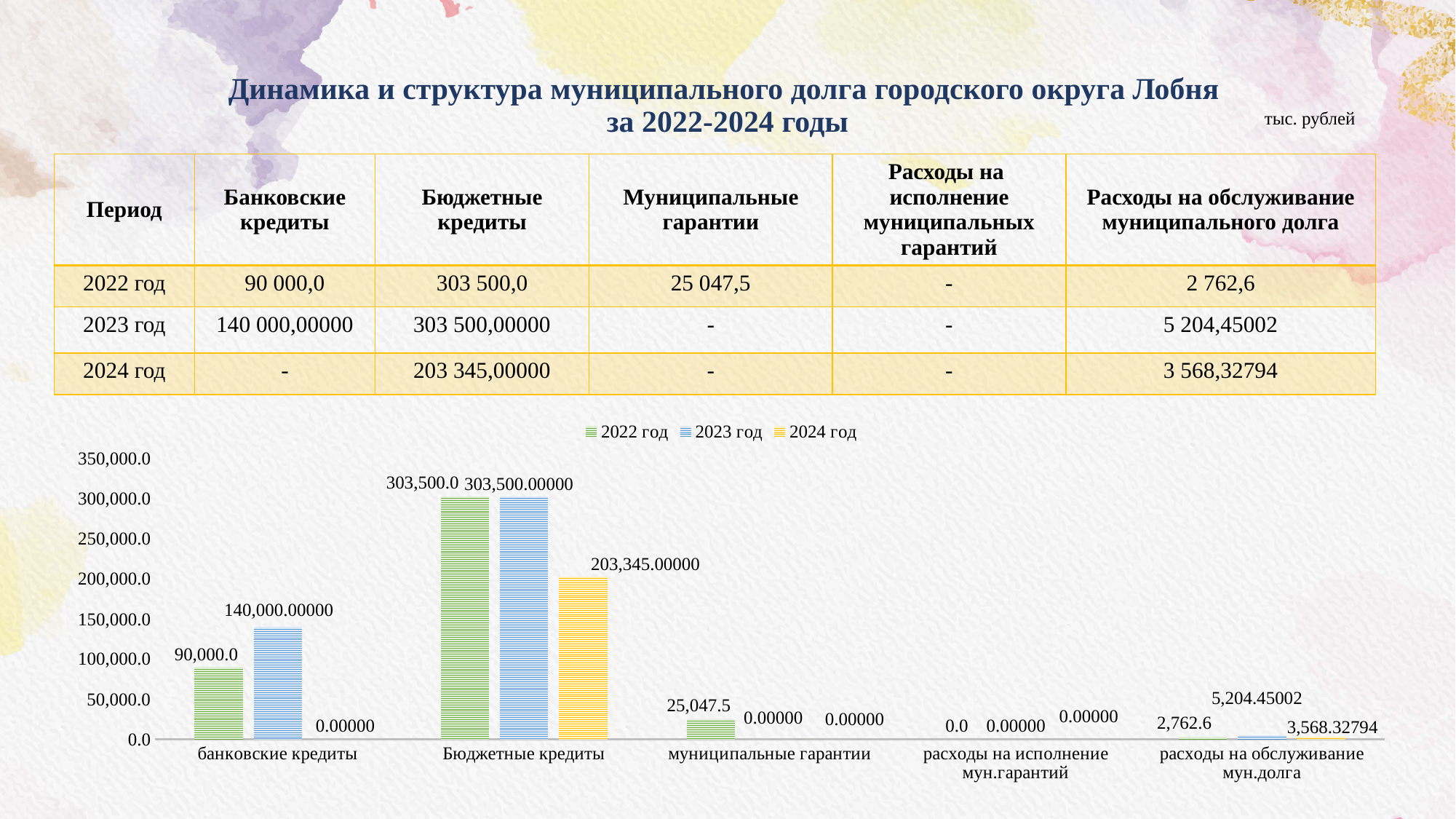
Is the value for 2024 год in Бюджетные кредиты greater or less than 250,000.0? less Which category has the highest value for 2022 год? Бюджетные кредиты What is the value for 2023 год in the банковские кредиты category? 140,000.00000 Which is larger for банковские кредиты: the 2022 год value or the 2023 год value? 2023 год How many series does the chart legend list? 3 How many categories are shown on the x axis of the chart? 5 What is the value for 2024 год in the Бюджетные кредиты category? 203,345.00000 What is the value for 2022 год in the муниципальные гарантии category? 25,047.5 What kind of chart is shown on the slide? bar chart What is the difference between the 2023 год and 2024 год values for Бюджетные кредиты? 100,155.00000 What is the value for 2023 год in the расходы на обслуживание мун.долга category? 5,204.45002 What is the difference between the 2023 год and 2022 год values for банковские кредиты? 50,000